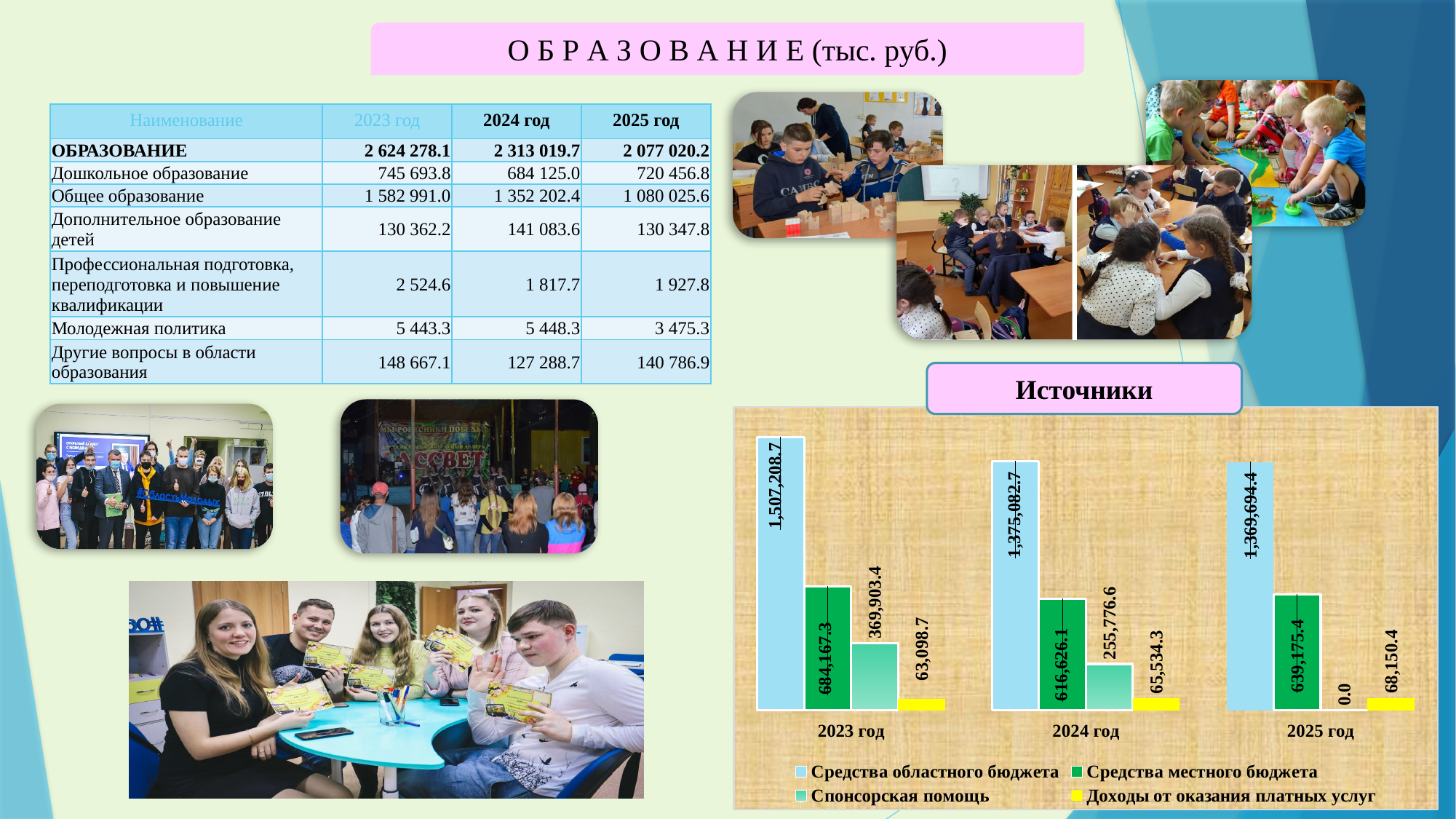
In the Источники chart, what is the value of Спонсорская помощь for 2025 год? 0.0 In the Источники chart, does the value of Средства областного бюджета rise or fall from 2023 год to 2025 год? fall In the Источники chart, which year has the lowest value for Спонсорская помощь? 2025 год In the Источники chart, which year has the highest value for Средства областного бюджета? 2023 год In the Источники chart, what is the value of Средства местного бюджета for 2024 год? 616,626.1 What kind of chart is the Источники chart? bar chart How many series does the legend of the Источники chart list? 4 In the Источники chart, what is the value of Средства областного бюджета for 2023 год? 1,507,208.7 How many years are shown on the x axis of the Источники chart? 3 In the Источники chart, what is the difference between Спонсорская помощь in 2023 год and 2024 год? 114,126.8 In the Источники chart, what is the value of Доходы от оказания платных услуг for 2025 год? 68,150.4 In the Источники chart, which is larger: Средства местного бюджета in 2024 год or in 2025 год? 2025 год